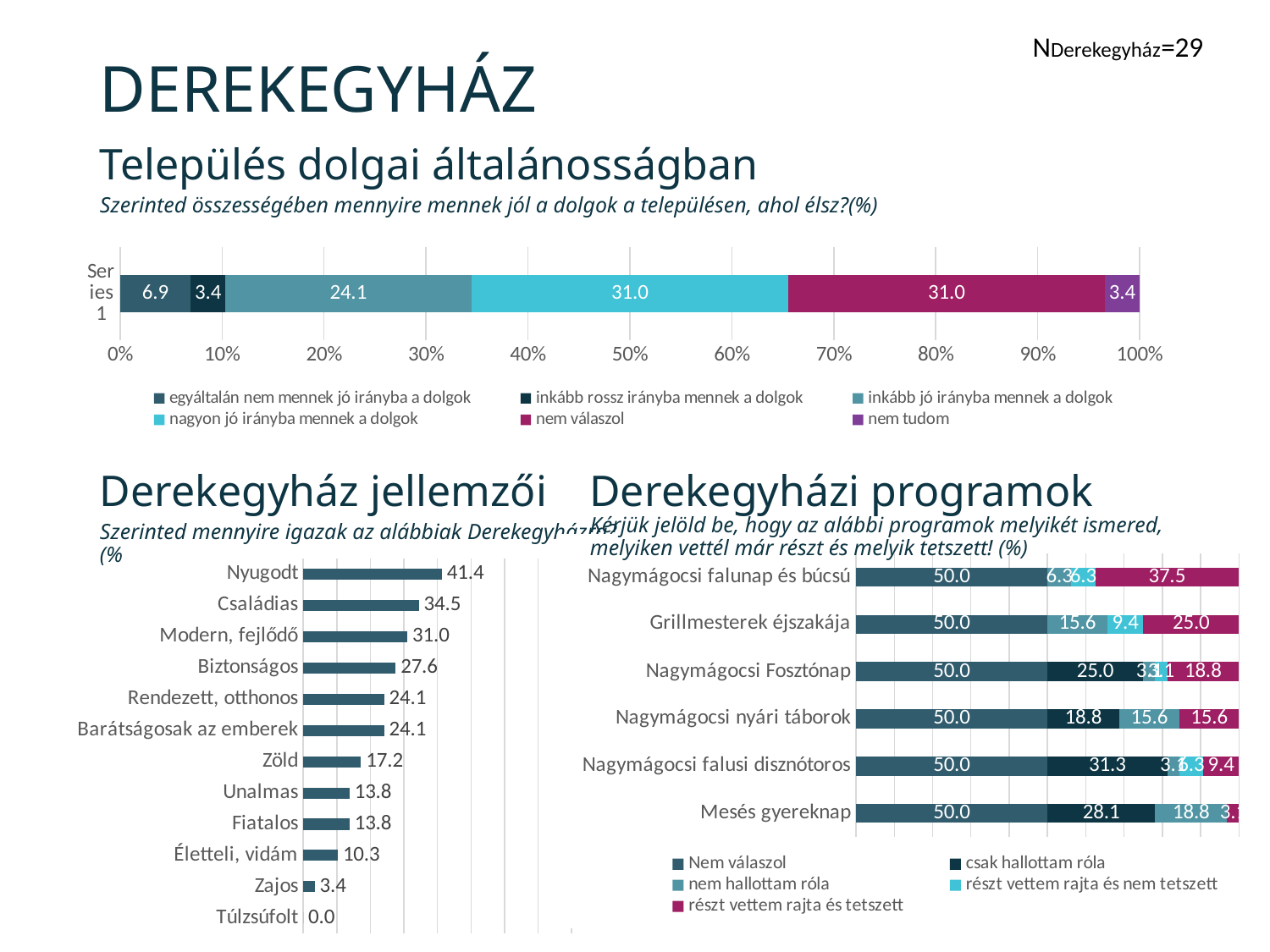
In the 'Település dolgai általánosságban' chart, what is the value for 'nagyon jó irányba mennek a dolgok'? 31.0 What kind of chart is the 'Derekegyház jellemzői' chart? bar chart How many categories are shown in the 'Derekegyház jellemzői' chart? 12 In the 'Derekegyház jellemzői' chart, which category has the lowest value? Túlzsúfolt In the 'Település dolgai általánosságban' chart, what is the value for 'inkább jó irányba mennek a dolgok'? 24.1 In the 'Derekegyház jellemzői' chart, what is the difference between 'Családias' and 'Zöld'? 17.3 In the 'Derekegyházi programok' chart, what is the 'részt vettem rajta és tetszett' value for 'Nagymágocsi falunap és búcsú'? 37.5 How many series does the legend of the 'Település dolgai általánosságban' chart list? 6 In the 'Derekegyház jellemzői' chart, what is the value for 'Nyugodt'? 41.4 In the 'Derekegyházi programok' chart, which is larger: the 'csak hallottam róla' value for 'Grillmesterek éjszakája' or for 'Mesés gyereknap'? Mesés gyereknap In the 'Derekegyház jellemzői' chart, which category has the highest value? Nyugodt In the 'Derekegyházi programok' chart, what is the 'csak hallottam róla' value for 'Nagymágocsi falusi disznótoros'? 31.3